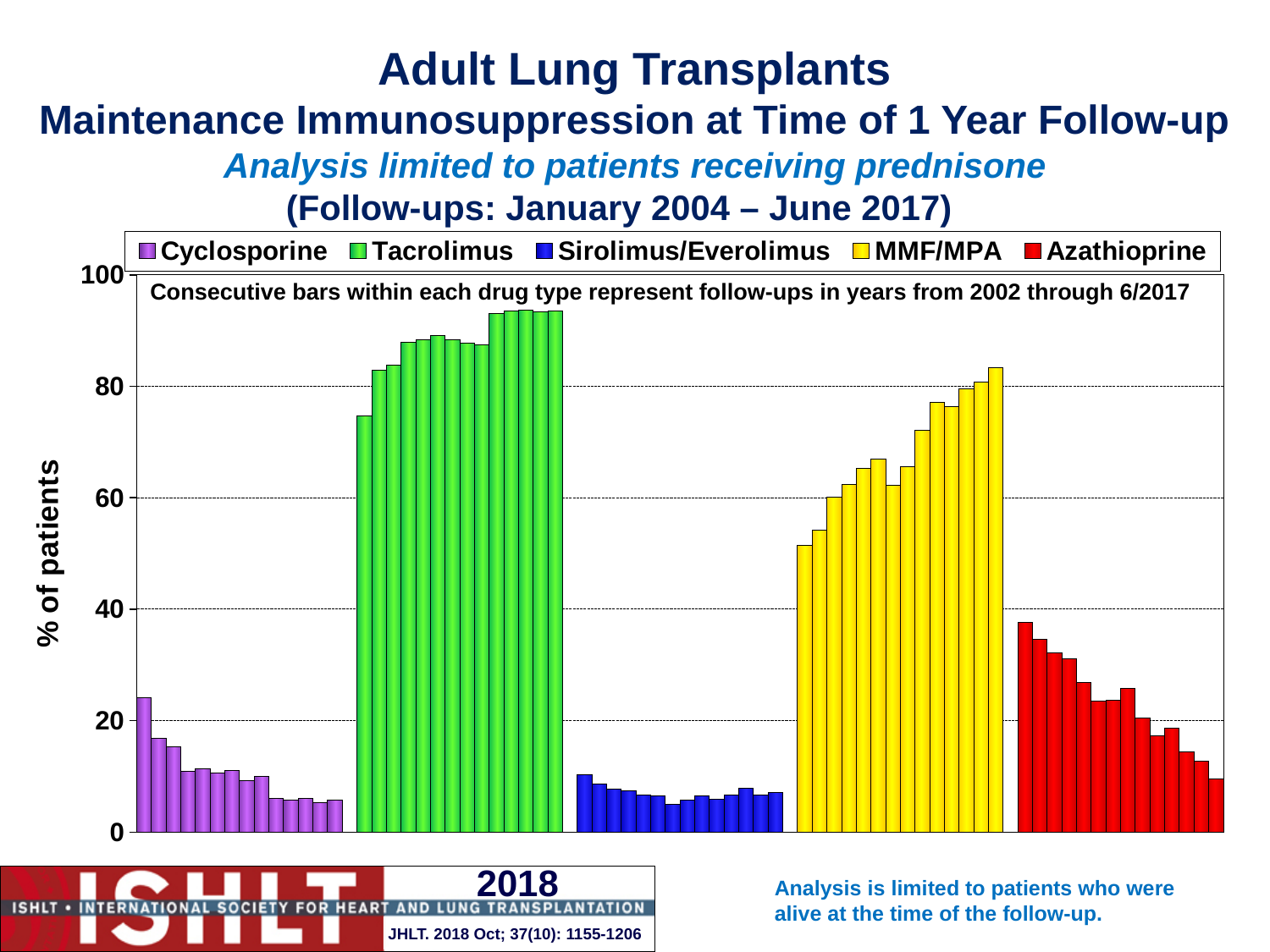
Which is larger, the percentage of patients on Tacrolimus or on Cyclosporine? Tacrolimus What kind of chart is shown on the slide? bar chart How many drug types does the legend list? 5 Is the value for the first Azathioprine bar greater or less than 40? less Do the Azathioprine bars rise or fall across the follow-up years? fall Do the Tacrolimus bars rise or fall across the follow-up years? rise Do the Cyclosporine bars rise or fall across the follow-up years? fall What is the label of the y axis? % of patients Which drug type has the highest percentage of patients? Tacrolimus Is the value for the last MMF/MPA bar greater or less than 80? greater Which drug type has the lowest percentage of patients? Sirolimus/Everolimus Is the value for the first Tacrolimus bar greater or less than 60? greater